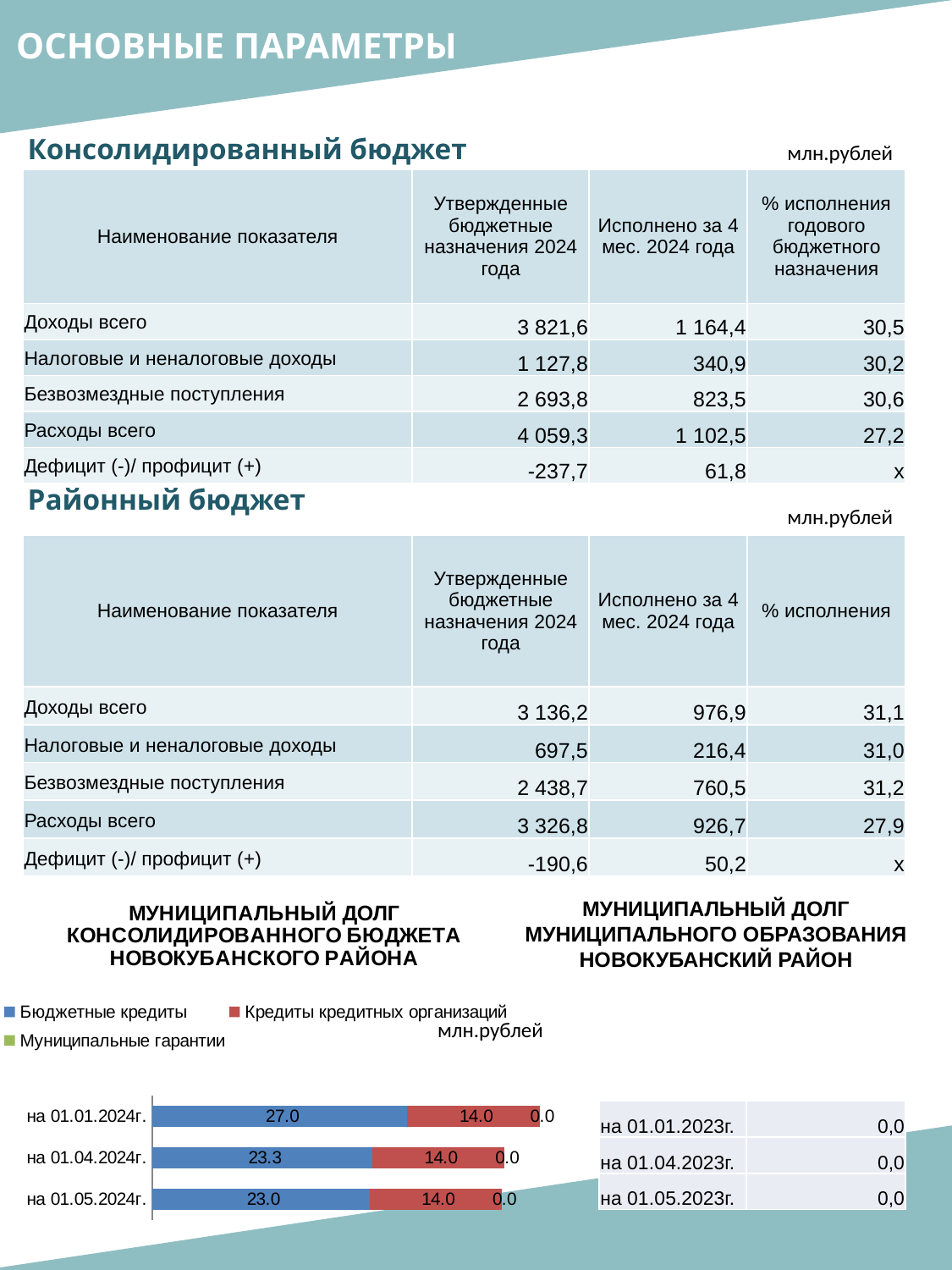
How many series does the legend of the municipal debt chart list? 3 In the municipal debt chart, does 'Бюджетные кредиты' rise or fall from 01.01.2024 to 01.05.2024? fall In the municipal debt chart, on which date is 'Бюджетные кредиты' highest? на 01.01.2024г. In the municipal debt chart, what is the value of 'Кредиты кредитных организаций' on 01.04.2024? 14.0 In the municipal debt chart, on which date is 'Бюджетные кредиты' lowest? на 01.05.2024г. In the municipal debt chart, what is the value of 'Бюджетные кредиты' on 01.05.2024? 23.0 In the municipal debt chart, what is the difference between 'Бюджетные кредиты' on 01.01.2024 and on 01.05.2024? 4.0 In the municipal debt chart, what is the total of the stacked bar for 01.01.2024? 41.0 In the municipal debt chart, what is the value of 'Муниципальные гарантии' on 01.01.2024? 0.0 In the municipal debt chart, what is the value of 'Бюджетные кредиты' on 01.01.2024? 27.0 How many dates (categories) are shown on the municipal debt chart? 3 What kind of chart is shown under the title 'МУНИЦИПАЛЬНЫЙ ДОЛГ КОНСОЛИДИРОВАННОГО БЮДЖЕТА НОВОКУБАНСКОГО РАЙОНА'? bar chart